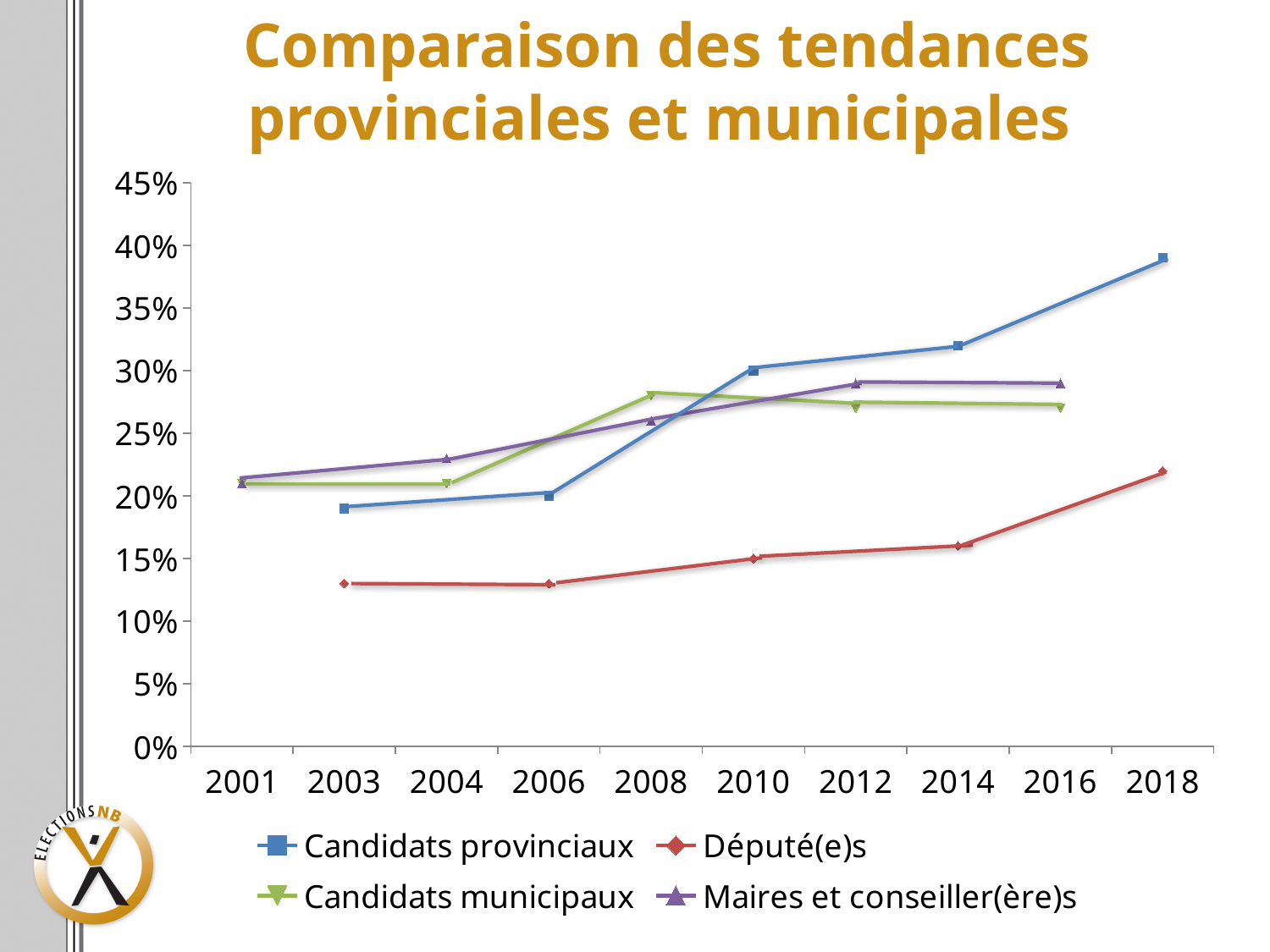
Is the value for Candidats municipaux in 2008 greater or less than 25%? greater How many series does the legend list? 4 What is the value for Candidats provinciaux in 2010? 30% What kind of chart is shown on the slide? line chart Is the value for Député(e)s in 2018 greater or less than 20%? greater Do the values for Candidats provinciaux rise or fall from 2003 to 2018? rise What is the value for Député(e)s in 2010? 15% In 2016, which is higher: Maires et conseiller(ère)s or Candidats municipaux? Maires et conseiller(ère)s Is the value for Candidats provinciaux in 2018 greater or less than 35%? greater How many years are shown on the x axis? 10 What is the value for Candidats provinciaux in 2006? 20% Which series has the lowest values across the whole chart? Député(e)s